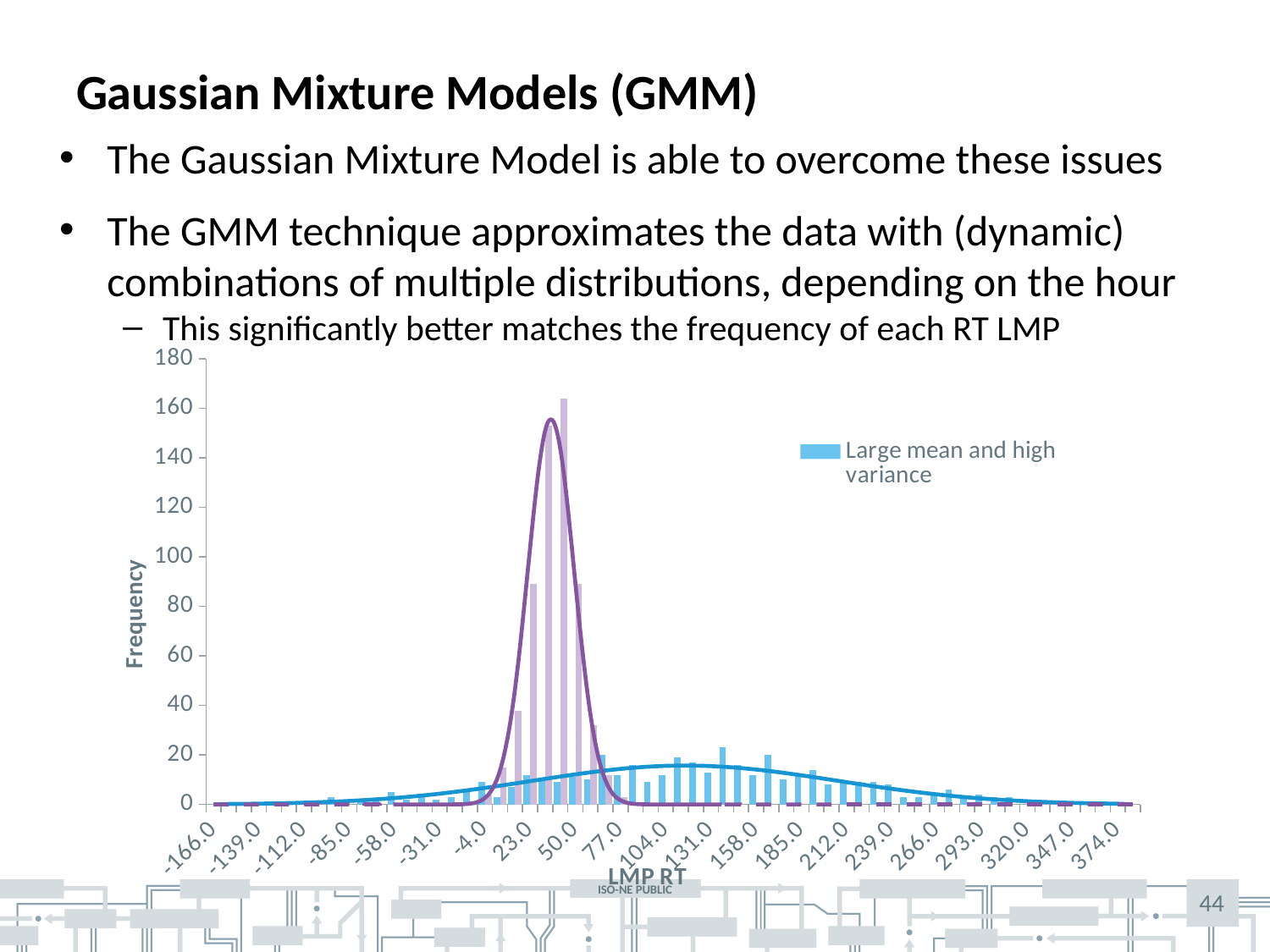
What is the title of the vertical axis of the chart? Frequency Is the tallest purple bar in the chart greater or less than 100? greater How many series does the chart's legend list? 1 How many tick labels are printed along the horizontal axis of the chart? 21 Is the tallest blue bar in the chart greater or less than 40? less What kind of chart is shown on the slide? combination bar and line chart Is the tallest purple bar in the chart greater or less than 140? greater What entry does the chart's legend list? Large mean and high variance What is the leftmost label on the horizontal axis of the chart? -166.0 Which is taller, the tallest purple bar or the tallest blue bar? the tallest purple bar What is the rightmost label on the horizontal axis of the chart? 374.0 What is the highest value shown on the vertical axis of the chart? 180